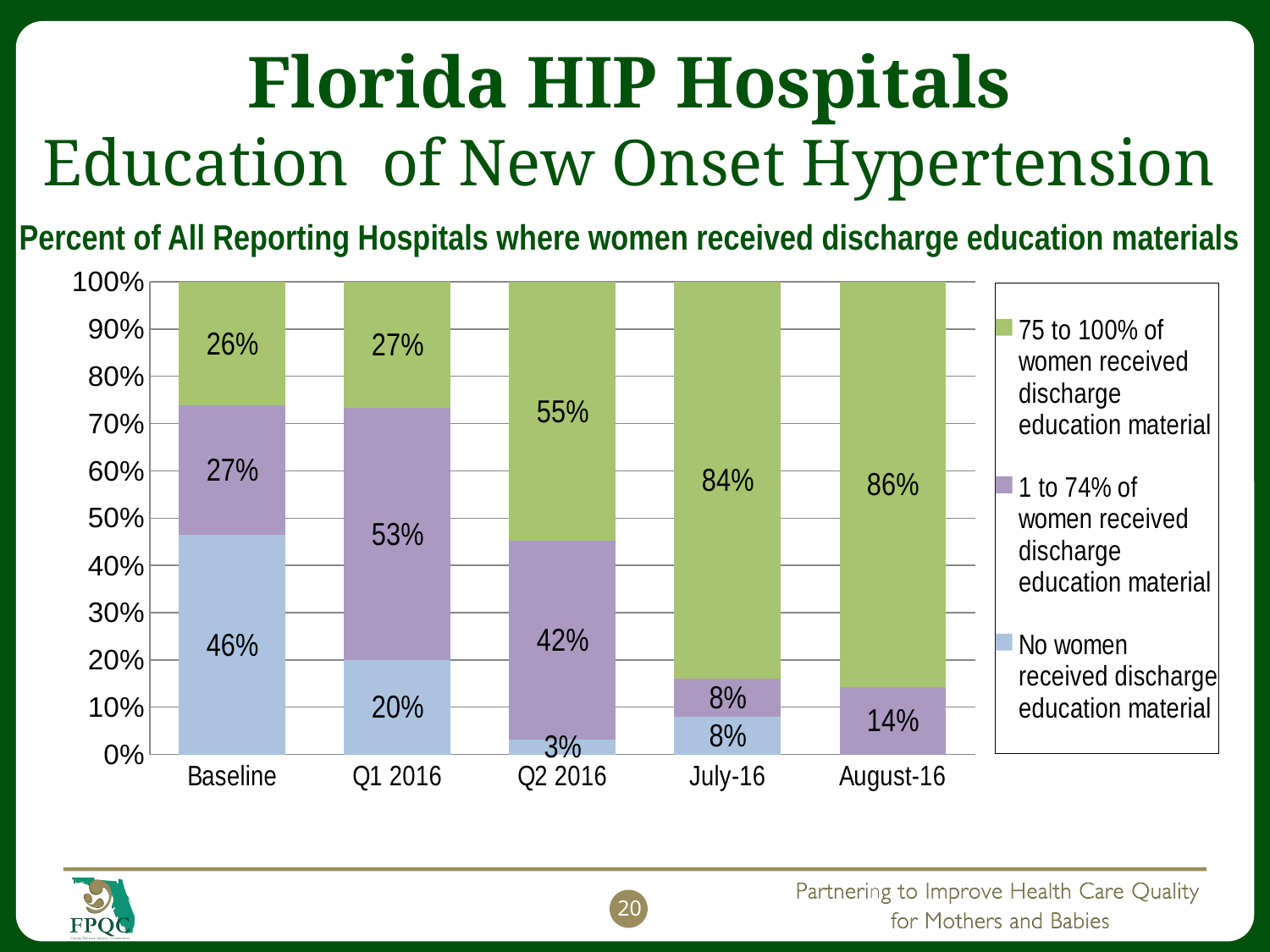
What is the value for 'No women received discharge education material' in Q2 2016? 3% What is the value for '75 to 100% of women received discharge education material' in July-16? 84% Which is larger: the 'No women received discharge education material' value at Baseline or in Q1 2016? Baseline In which category is the '75 to 100% of women received discharge education material' value highest? August-16 How many series does the legend list? 3 In which category is the '75 to 100% of women received discharge education material' value lowest? Baseline Does the '75 to 100% of women received discharge education material' series rise or fall from Baseline to August-16? rise What is the value for 'No women received discharge education material' at Baseline? 46% What is the value for '1 to 74% of women received discharge education material' in Q1 2016? 53% What kind of chart is shown on the slide? stacked bar chart How many categories are shown along the x axis? 5 What is the difference between the '75 to 100% of women received discharge education material' values for Q2 2016 and Q1 2016? 28%